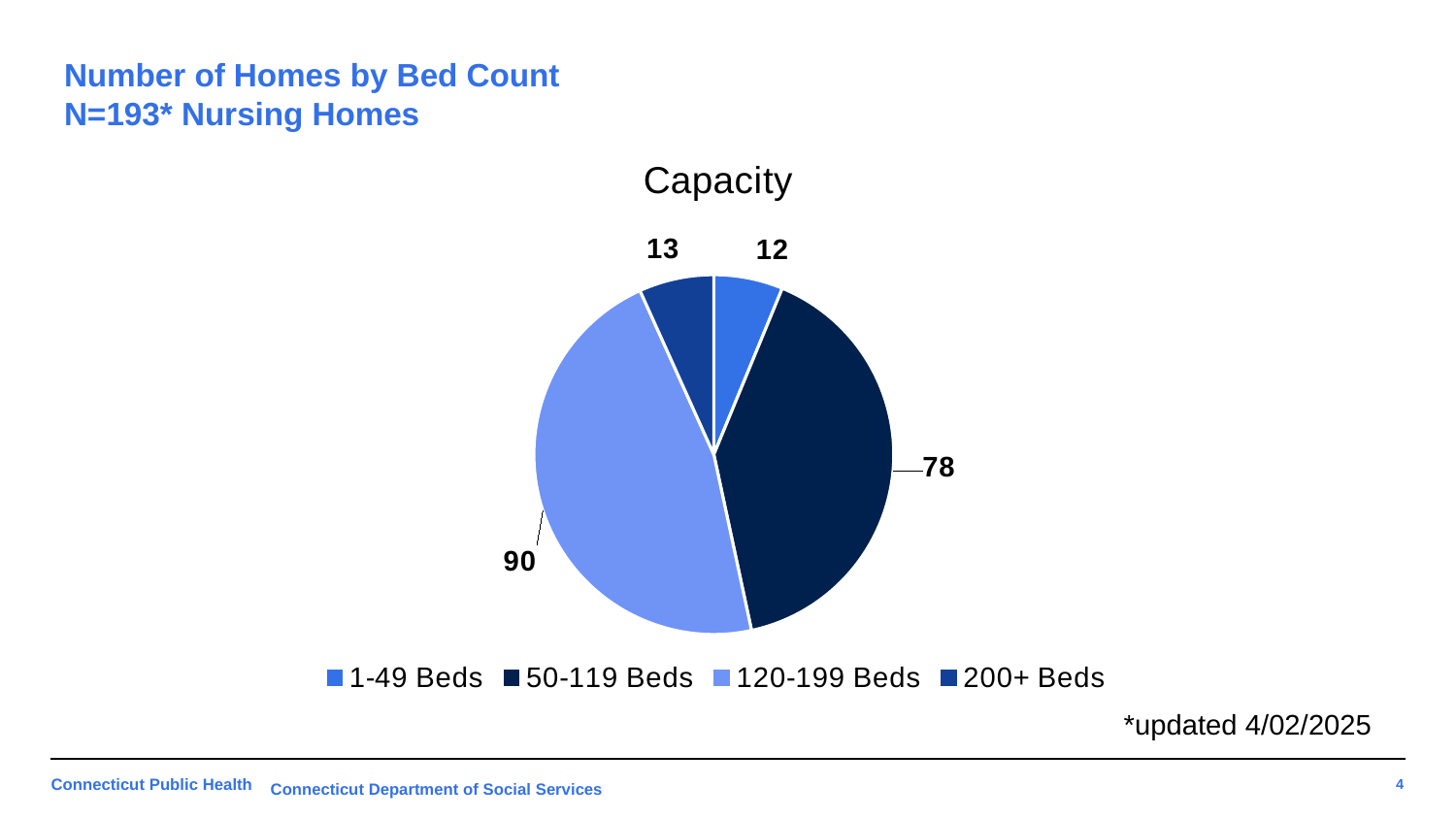
Which bed-count category has the smallest number of homes? 1-49 Beds How many homes have 1-49 beds? 12 How many categories does the legend list? 4 What is the total number of nursing homes across all slices of the pie? 193 Which bed-count category has the largest number of homes? 120-199 Beds How many homes have 50-119 beds? 78 How many homes have 200+ beds? 13 What is the difference between the number of homes with 120-199 beds and those with 50-119 beds? 12 What is the title of the chart? Capacity What type of chart is shown on the slide? pie chart How many homes have 120-199 beds? 90 Which has more homes: 200+ Beds or 1-49 Beds? 200+ Beds